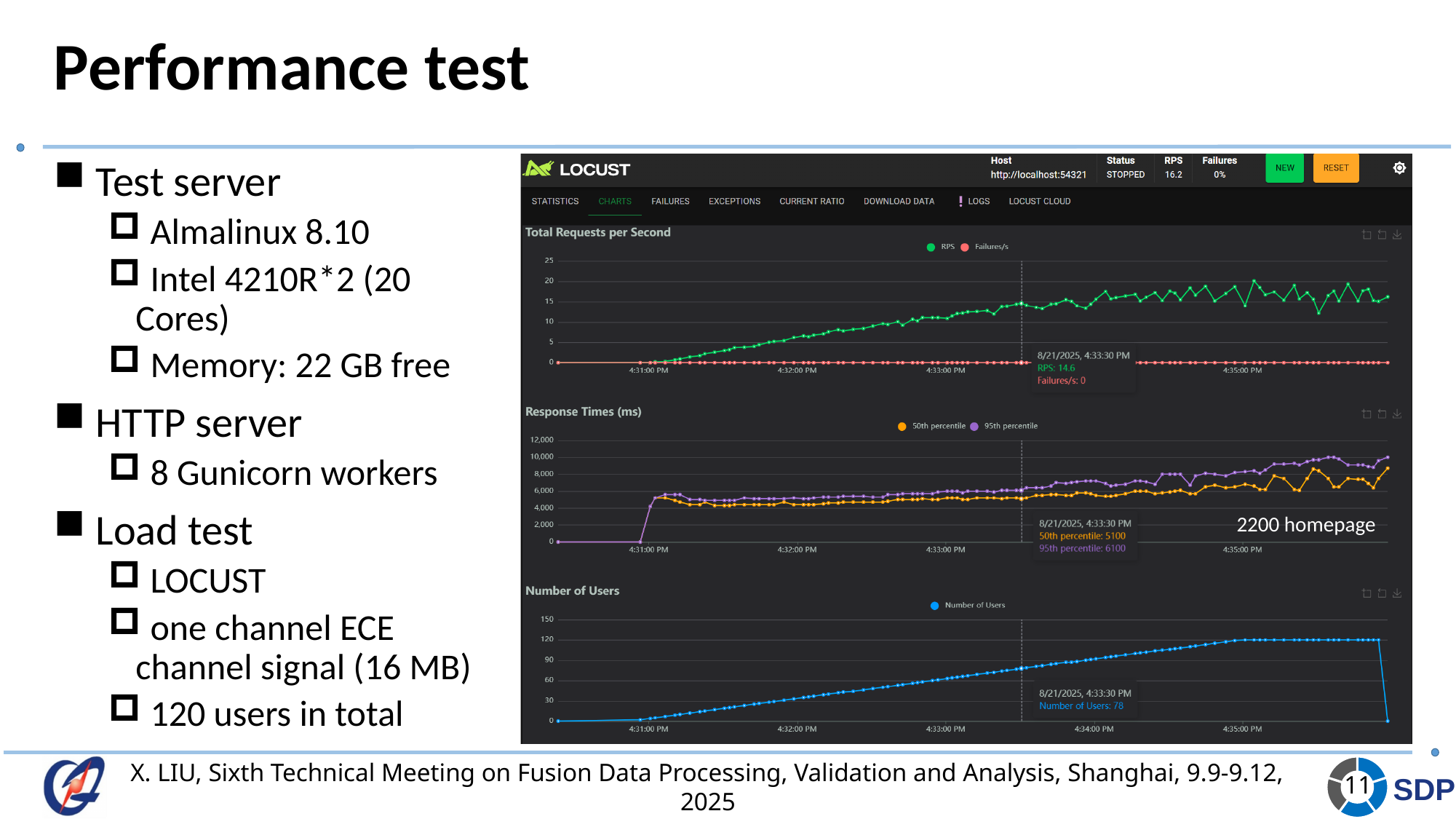
In the 'Total Requests per Second' chart, is the RPS value at 4:32:00 PM greater or less than 10? less In the 'Total Requests per Second' chart, what is the Failures/s value shown in the tooltip at 4:33:30 PM? 0 How many series does the legend of the 'Total Requests per Second' chart list? 2 In the 'Number of Users' chart, does the number of users rise or fall between 4:31:00 PM and 4:35:00 PM? rise In the 'Number of Users' chart, is the value at 4:35:00 PM greater or less than 90? greater In the 'Total Requests per Second' chart, what is the RPS value shown in the tooltip at 8/21/2025, 4:33:30 PM? 14.6 In the 'Number of Users' chart, what is the Number of Users shown in the tooltip at 4:33:30 PM? 78 In the 'Response Times (ms)' chart, what is the 95th percentile value shown in the tooltip at 4:33:30 PM? 6100 What kind of chart is the 'Total Requests per Second' chart? line chart In the 'Response Times (ms)' chart, what is the 50th percentile value shown in the tooltip at 4:33:30 PM? 5100 How many series does the legend of the 'Response Times (ms)' chart list? 2 In the 'Response Times (ms)' chart, what is the difference between the 95th percentile and the 50th percentile at 4:33:30 PM? 1000